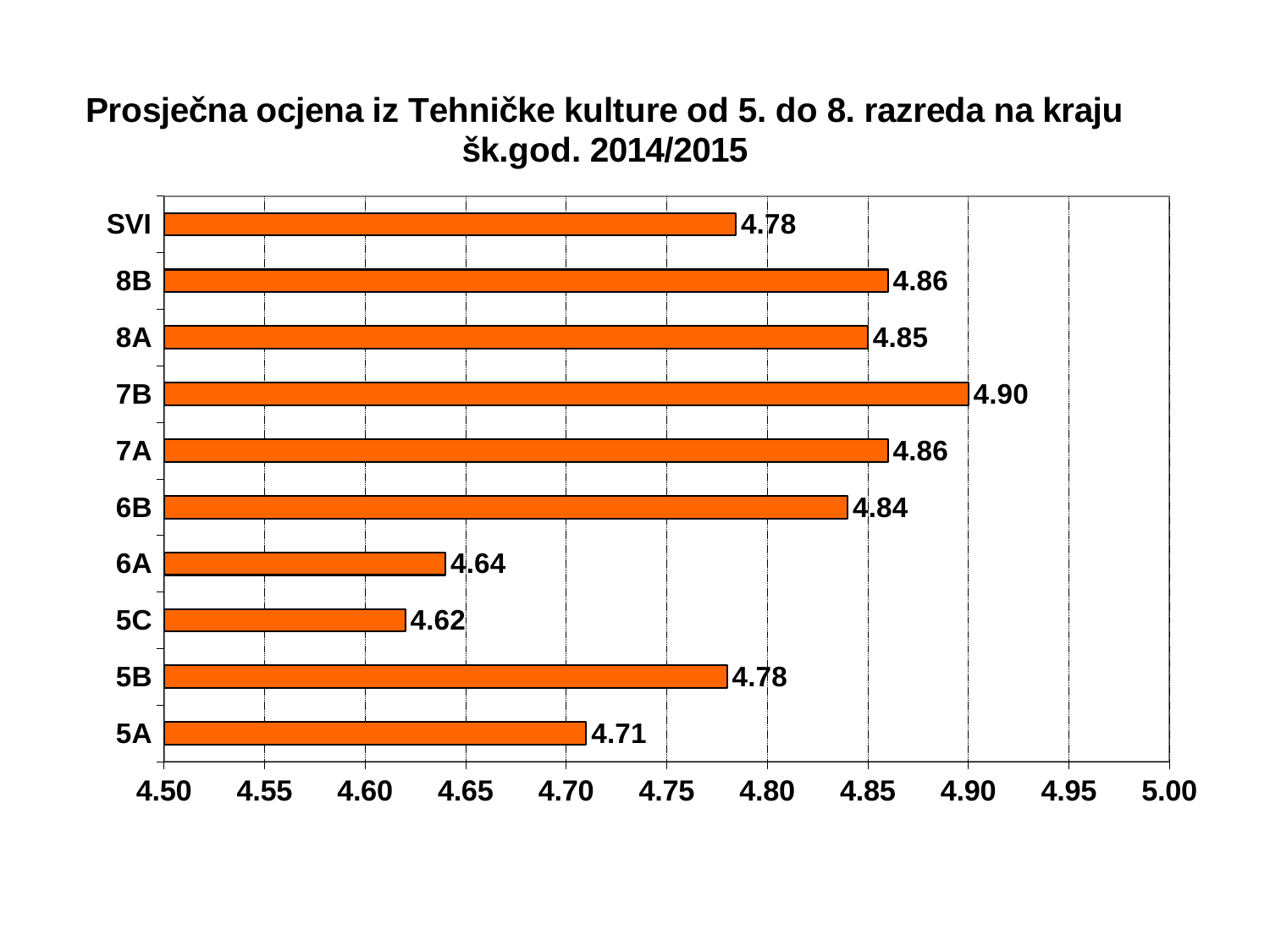
Which class has the highest average grade? 7B What kind of chart is shown on the slide? bar chart What is the average grade for class 7B? 4.90 What is the difference between the values for 8B and 6A? 0.22 What is the value shown for SVI? 4.78 How many categories are shown on the chart? 10 Is the value for 6B greater or less than 4.80? greater What is the difference between the values for 7B and 5C? 0.28 What is the title of the chart? Prosječna ocjena iz Tehničke kulture od 5. do 8. razreda na kraju šk.god. 2014/2015 What is the average grade for class 5C? 4.62 Which is larger, the value for 5A or the value for 5B? 5B Which class has the lowest average grade? 5C